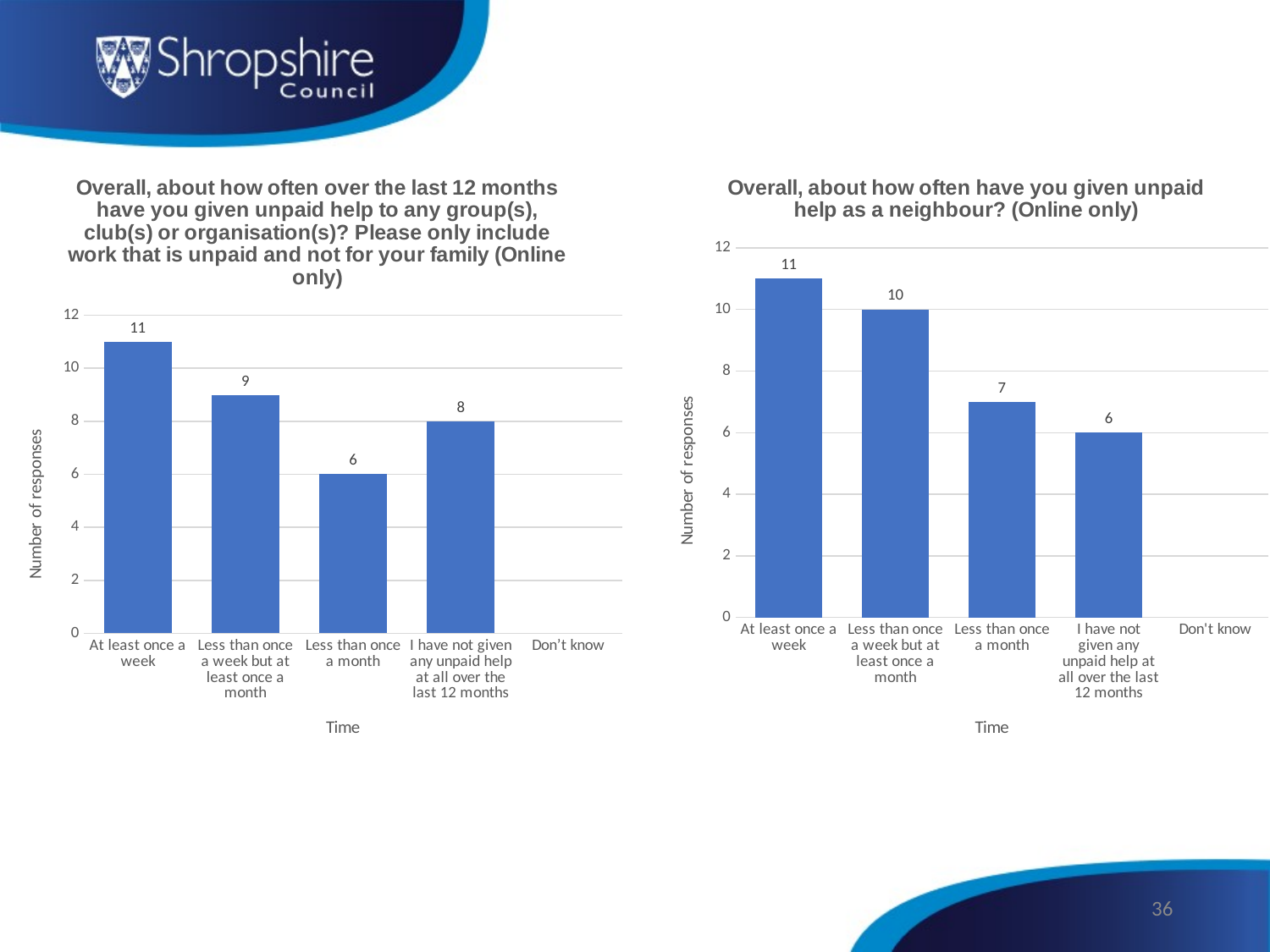
In the left chart (unpaid help to groups, clubs or organisations), how many categories are shown on the x axis? 5 In the right chart (unpaid help as a neighbour), how many responses are there for 'Less than once a week but at least once a month'? 10 What is the y-axis label of the left chart (unpaid help to groups, clubs or organisations)? Number of responses In the left chart (unpaid help to groups, clubs or organisations), how many responses are there for 'At least once a week'? 11 In the left chart (unpaid help to groups, clubs or organisations), what is the difference in responses between 'Less than once a week but at least once a month' and 'I have not given any unpaid help at all over the last 12 months'? 1 What type of chart is the right chart (unpaid help as a neighbour)? bar chart In the right chart (unpaid help as a neighbour), what is the difference in responses between 'At least once a week' and 'Less than once a month'? 4 In the right chart (unpaid help as a neighbour), which of 'Less than once a month' or 'I have not given any unpaid help at all over the last 12 months' has more responses? Less than once a month In the right chart (unpaid help as a neighbour), how many responses are there for 'I have not given any unpaid help at all over the last 12 months'? 6 In the right chart (unpaid help as a neighbour), do the values rise or fall from left to right across the labelled bars? fall In the left chart (unpaid help to groups, clubs or organisations), which category has the highest number of responses? At least once a week In the left chart (unpaid help to groups, clubs or organisations), how many responses are there for 'Less than once a month'? 6